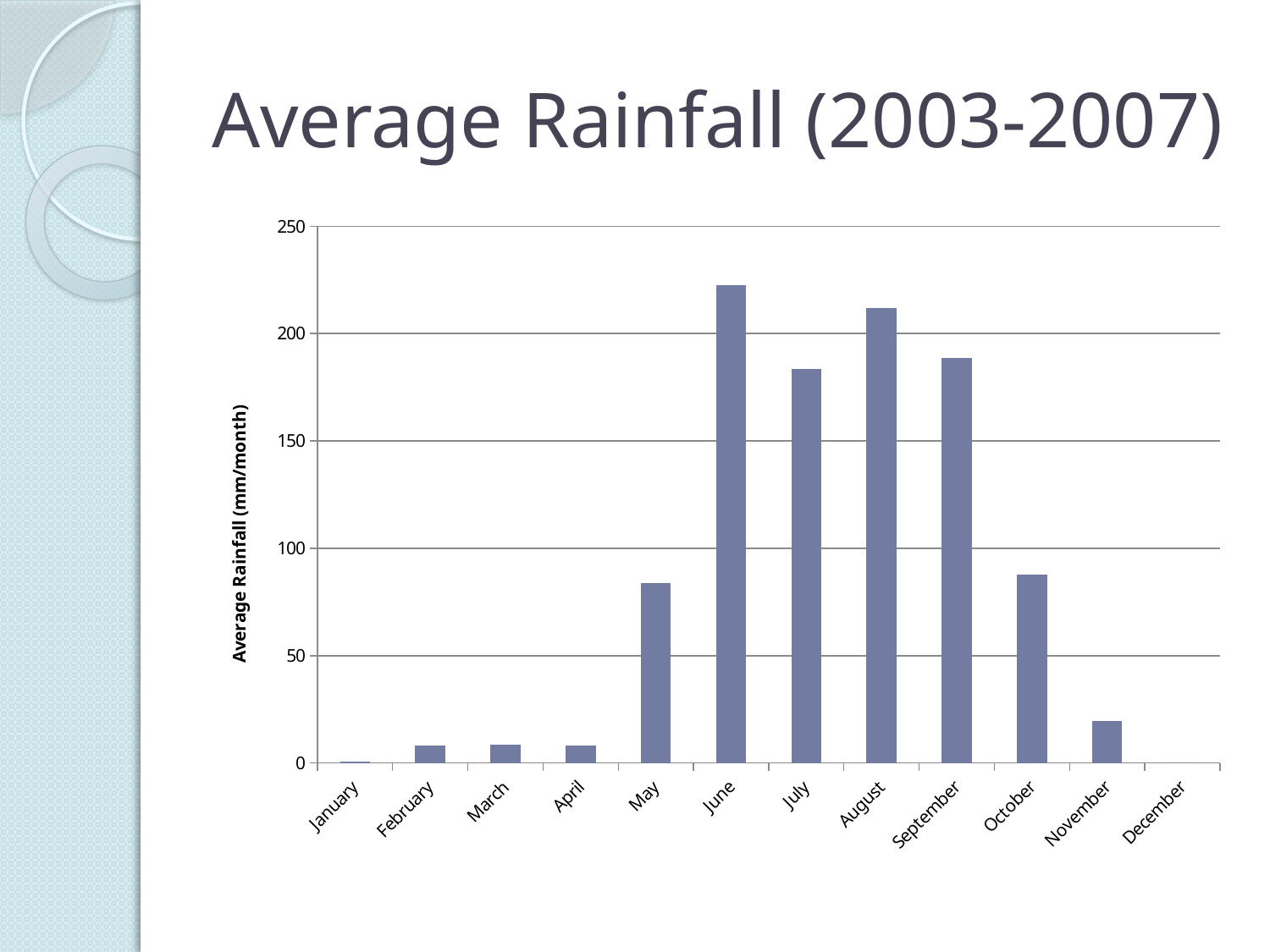
Which month has the highest average rainfall? June Is the value for November greater or less than 50? less What kind of chart is shown on the slide? bar chart What is the label on the vertical axis of the chart? Average Rainfall (mm/month) Is the value for May greater or less than 100? less Which has the larger average rainfall, August or October? August Is the value for June greater or less than 200? greater Do the values rise or fall from January to June? rise How many months are shown on the x axis of the chart? 12 Which has the larger average rainfall, June or July? June